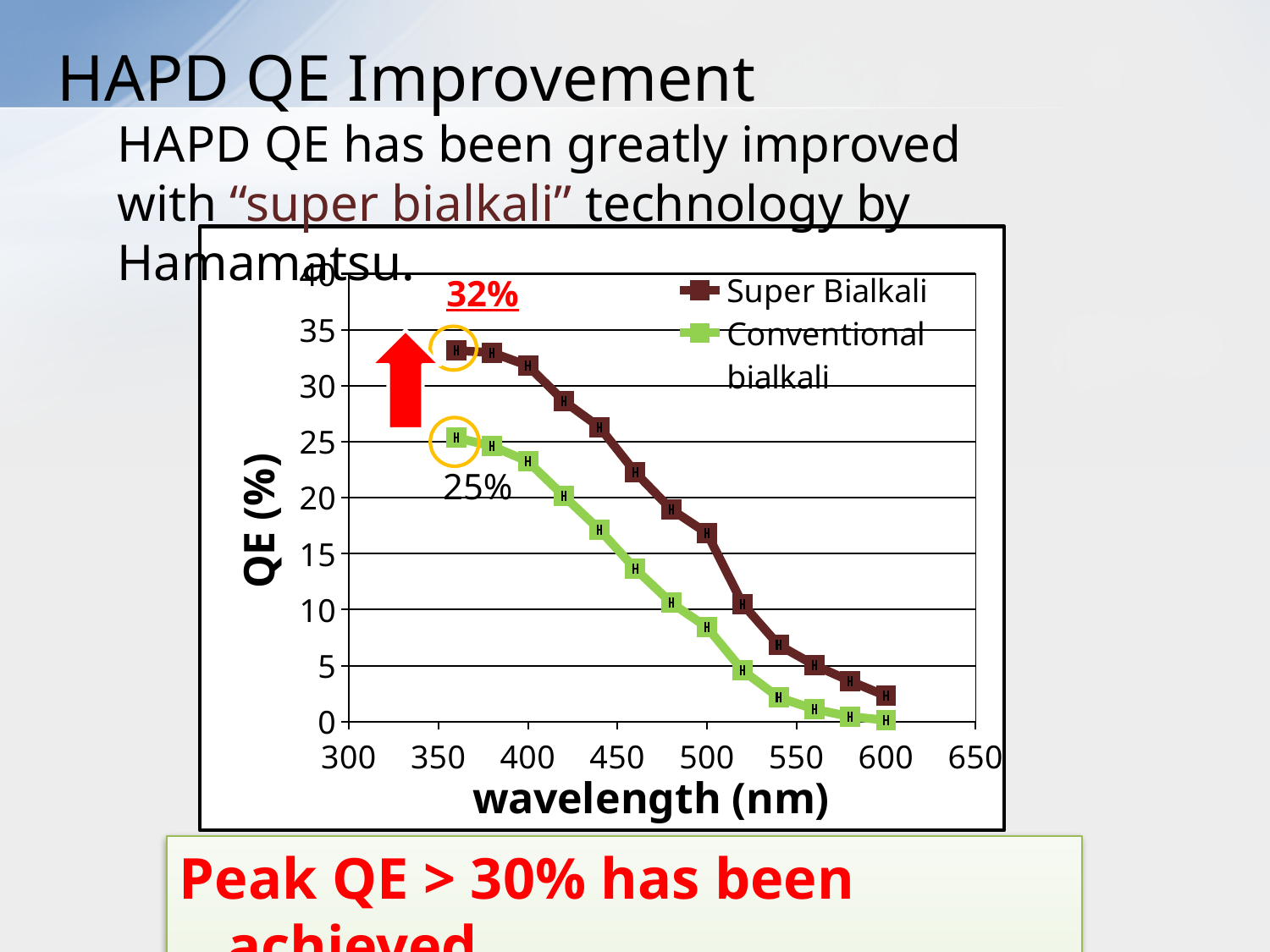
What is the difference between the annotated peak QE of Super Bialkali (32%) and Conventional bialkali (25%)? 7% Does the QE of the Conventional bialkali series rise or fall as wavelength increases from 400 nm to 600 nm? fall What peak QE value is annotated for the Super Bialkali series? 32% What kind of chart is shown on the slide? line chart Is the QE of the Conventional bialkali series at 500 nm greater or less than 10? less What peak QE value is annotated for the Conventional bialkali series? 25% What is the label of the y axis of the chart? QE (%) Which series has the higher QE at 500 nm, Super Bialkali or Conventional bialkali? Super Bialkali How many series does the chart legend list? 2 Is the QE of the Super Bialkali series at 500 nm greater or less than 15? greater What are the two series named in the chart legend? Super Bialkali and Conventional bialkali Is the QE of the Super Bialkali series at 600 nm greater or less than 5? less